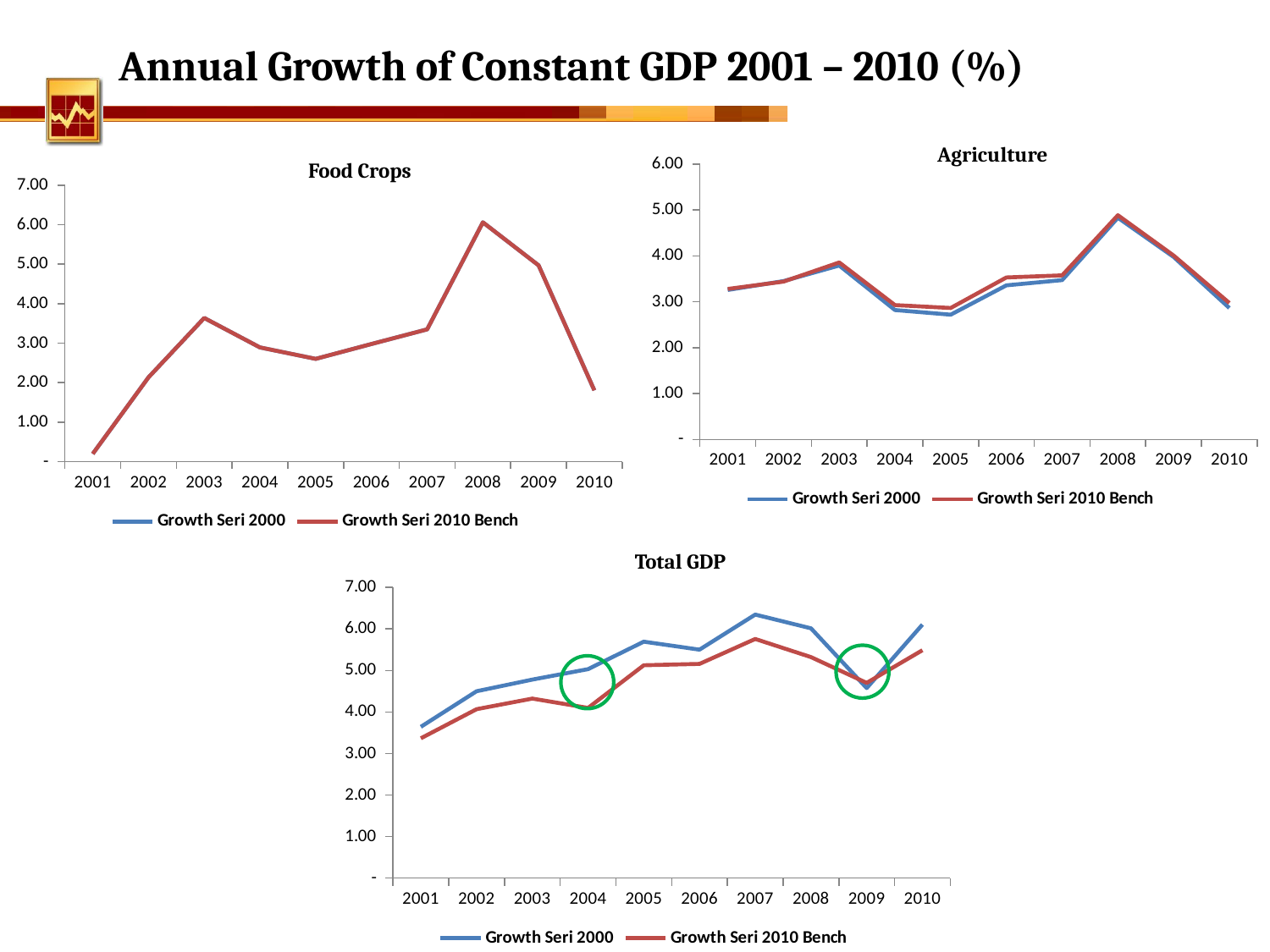
In the Food Crops chart, which year has the lowest growth value? 2001 In the Agriculture chart, which year has the highest growth value? 2008 In the Total GDP chart, which year has the lowest value for Growth Seri 2010 Bench? 2001 How many years are plotted on the x axis of the Total GDP chart? 10 How many series does the legend of the Agriculture chart list? 2 In the Agriculture chart, is the Growth Seri 2000 value for 2005 greater or less than 3.00? less In the Food Crops chart, do the values rise or fall from 2008 to 2010? fall What type of chart is the Food Crops chart? line chart In the Total GDP chart, which series has the larger value in 2007, Growth Seri 2000 or Growth Seri 2010 Bench? Growth Seri 2000 In the Total GDP chart, which year has the highest value for Growth Seri 2000? 2007 In the Food Crops chart, is the value for 2008 greater or less than 5.00? greater In the Food Crops chart, which year has the highest growth value? 2008